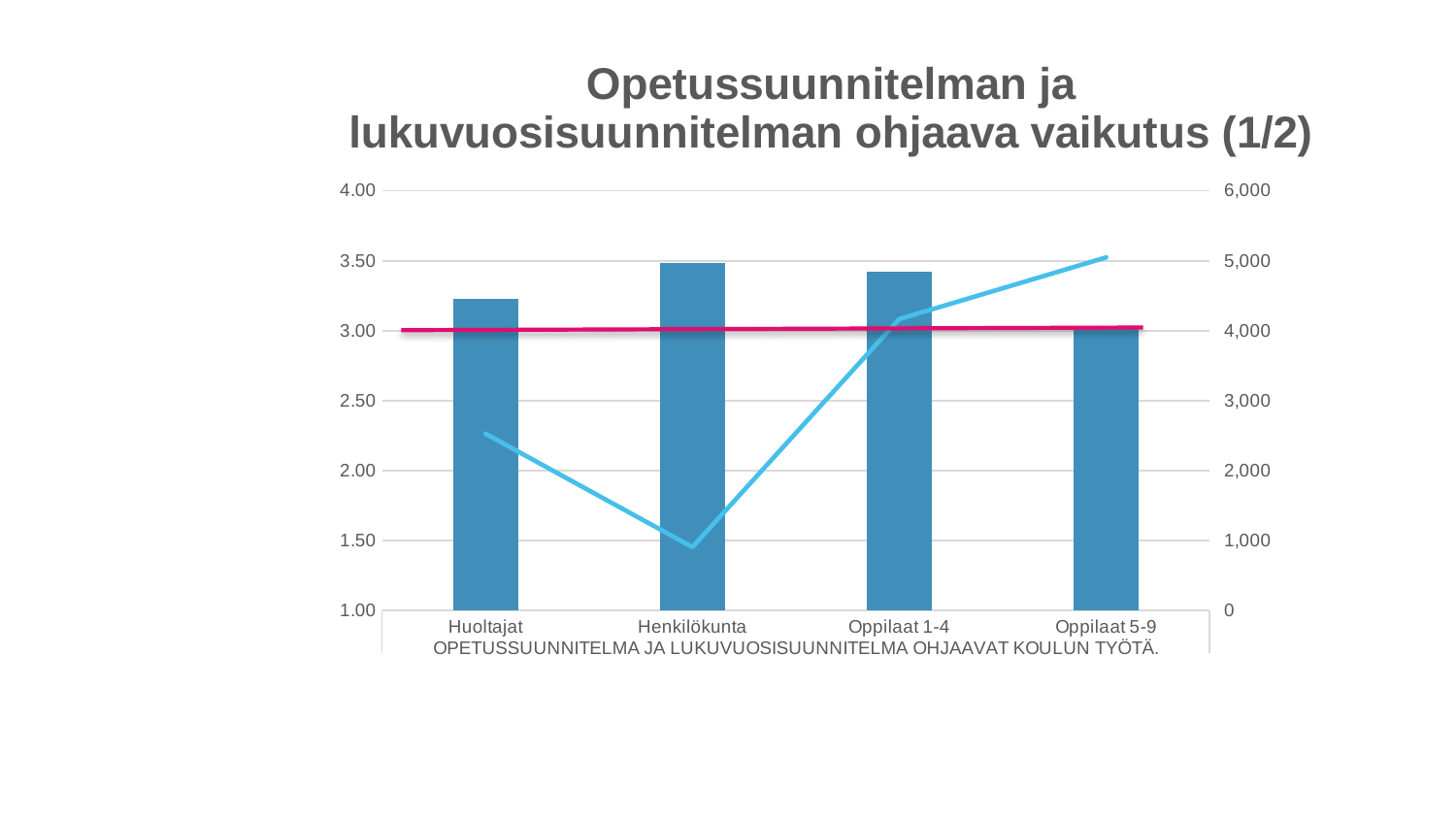
Which category has the lowest bar in the chart? Oppilaat 5-9 Which category has the highest bar in the chart? Henkilökunta At which category does the light blue line reach its lowest point? Henkilökunta Which bar is taller, Huoltajat or Oppilaat 5-9? Huoltajat Is the light blue line value for Henkilökunta greater or less than 1,000 on the right axis? less At which category does the light blue line reach its highest point? Oppilaat 5-9 What is the title of the chart slide? Opetussuunnitelman ja lukuvuosisuunnitelman ohjaava vaikutus (1/2) Does the light blue line rise or fall from Henkilökunta to Oppilaat 5-9? rises Is the bar value for Huoltajat greater or less than 3.00 on the left axis? greater How many categories are shown on the x axis of the chart? 4 Is the bar value for Huoltajat greater or less than 3.50 on the left axis? less